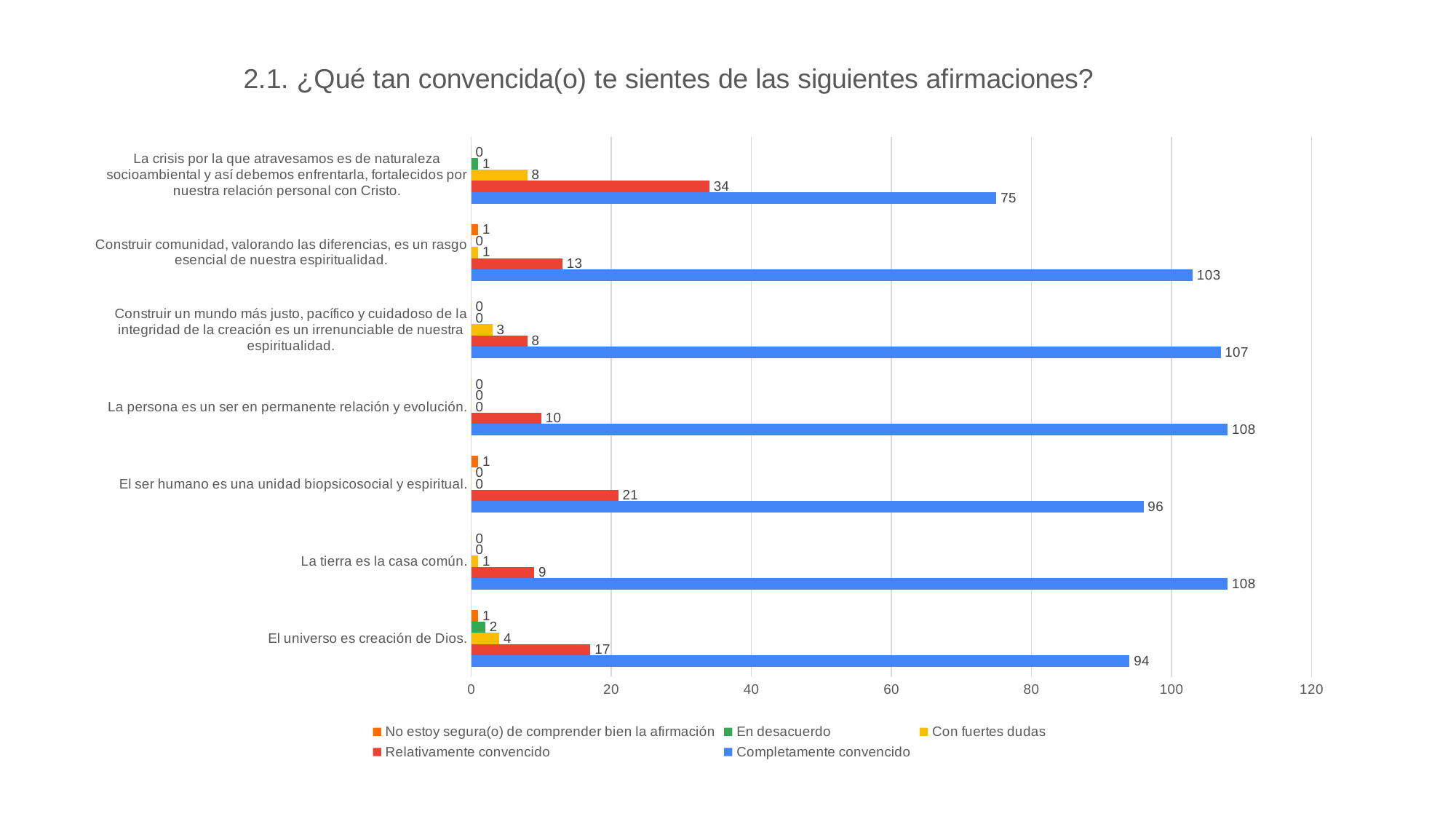
Which statement has the lowest value for "Completamente convencido"? La crisis por la que atravesamos es de naturaleza socioambiental y así debemos enfrentarla, fortalecidos por nuestra relación personal con Cristo. What is the value for "Completamente convencido" for the statement "La tierra es la casa común."? 108 How many series does the legend list? 5 Which statement has the highest value for "Relativamente convencido"? La crisis por la que atravesamos es de naturaleza socioambiental y así debemos enfrentarla, fortalecidos por nuestra relación personal con Cristo. What kind of chart is shown on the slide? bar chart What is the value for "En desacuerdo" for the statement "El universo es creación de Dios."? 2 What is the value for "Relativamente convencido" for the statement "El universo es creación de Dios."? 17 What is the value for "Con fuertes dudas" for the statement "La crisis por la que atravesamos es de naturaleza socioambiental y así debemos enfrentarla, fortalecidos por nuestra relación personal con Cristo."? 8 How many statements (categories) are shown on the chart? 7 Which statement has a larger "Completamente convencido" value: "El ser humano es una unidad biopsicosocial y espiritual." or "El universo es creación de Dios."? El ser humano es una unidad biopsicosocial y espiritual. Is the "Completamente convencido" value for "Construir un mundo más justo, pacífico y cuidadoso de la integridad de la creación es un irrenunciable de nuestra espiritualidad." greater or less than 100? greater For the statement "Construir comunidad, valorando las diferencias, es un rasgo esencial de nuestra espiritualidad.", what is the difference between the "Completamente convencido" and "Relativamente convencido" values? 90